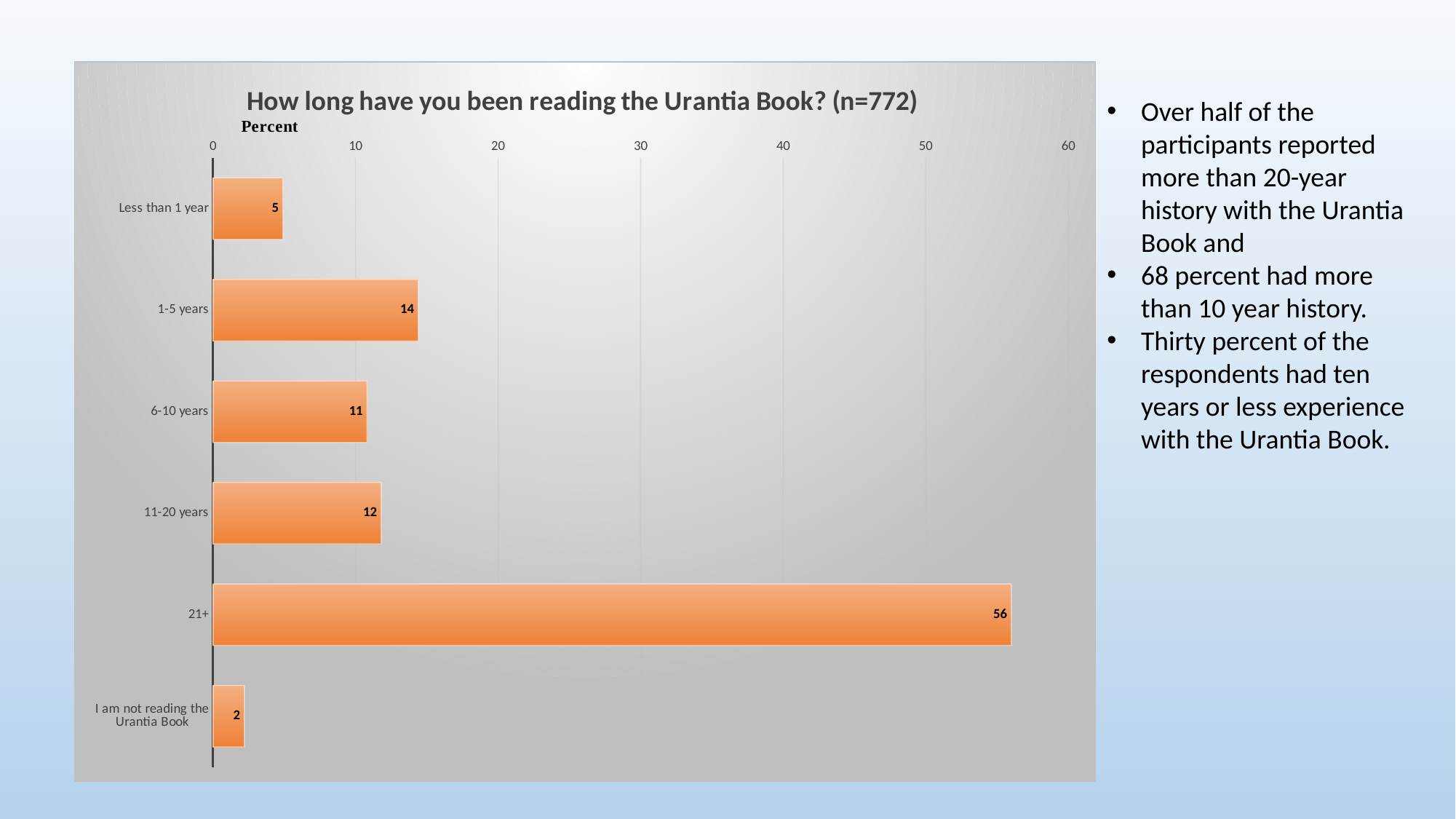
What is the value for the '6-10 years' category? 11 Is the value for '21+' greater or less than 50? greater Which category has the lowest value? I am not reading the Urantia Book Which is larger, the value for '1-5 years' or the value for '6-10 years'? 1-5 years What percent of respondents have been reading the Urantia Book for 21+ years? 56 What is the value for 'I am not reading the Urantia Book'? 2 Which category has the highest value? 21+ What is the difference between the values for '21+' and '11-20 years'? 44 What kind of chart is shown on the slide? Bar chart How many categories are shown in the chart? 6 What is the title of the chart? How long have you been reading the Urantia Book? (n=772) What is the value for the '1-5 years' category? 14